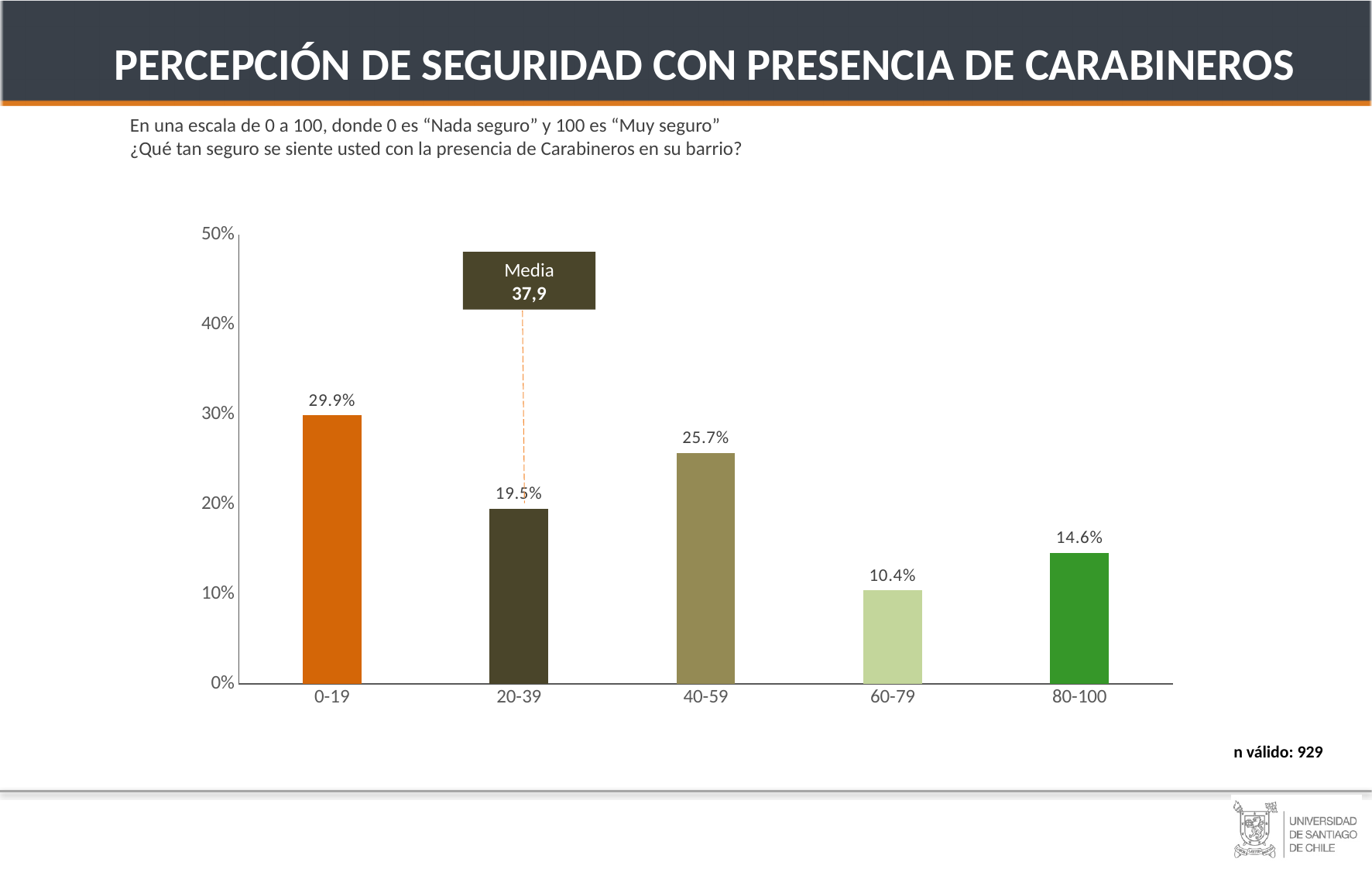
Is the value for 40-59 greater or less than 20%? greater What is the difference between the values for 0-19 and 20-39? 10.4% What kind of chart is shown on the slide? bar chart Which category has the lowest value? 60-79 What is the value for the 0-19 category? 29.9% What is the difference between the values for 40-59 and 80-100? 11.1% What mean (Media) value is shown in the box above the chart? 37,9 Which category has the highest value? 0-19 How many categories are shown on the x axis? 5 What is the value for the 60-79 category? 10.4% Which is larger, the value for 20-39 or the value for 40-59? 40-59 What is the value for the 80-100 category? 14.6%